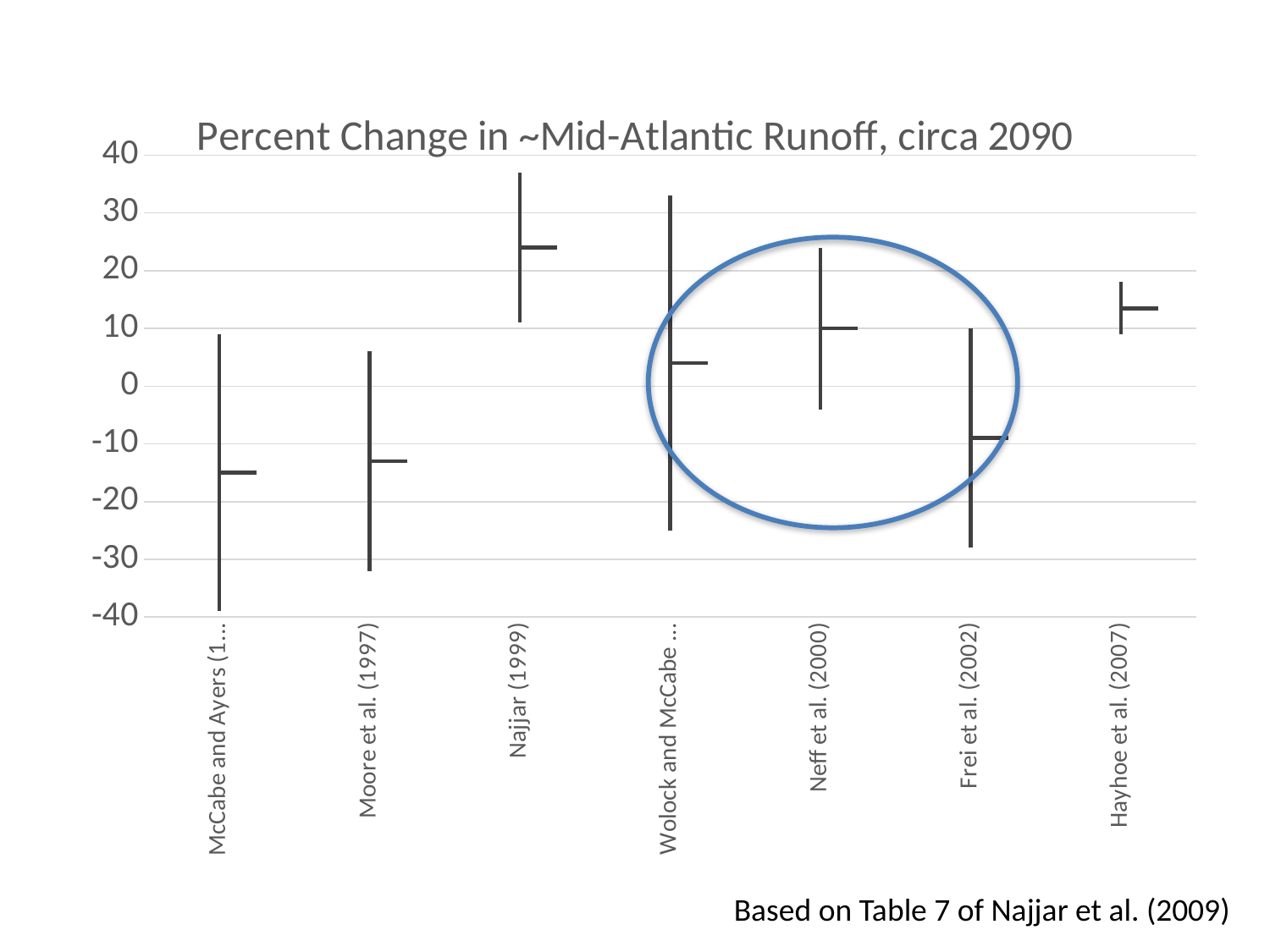
Is the central value for Frei et al. (2002) greater or less than 0? less Which two studies are highlighted by the blue circle on the chart? Neff et al. (2000) and Frei et al. (2002) Is the central value for Hayhoe et al. (2007) greater or less than 10? greater Is the central value for McCabe and Ayers greater or less than -10? less How many studies (categories) are plotted along the x axis? 7 Which study has the highest central value? Najjar (1999) Which has the larger central value, Najjar (1999) or Hayhoe et al. (2007)? Najjar (1999) Which has the larger central value, Wolock and McCabe or Frei et al. (2002)? Wolock and McCabe What is the lowest value shown on the y axis? -40 What is the title of the chart? Percent Change in ~Mid-Atlantic Runoff, circa 2090